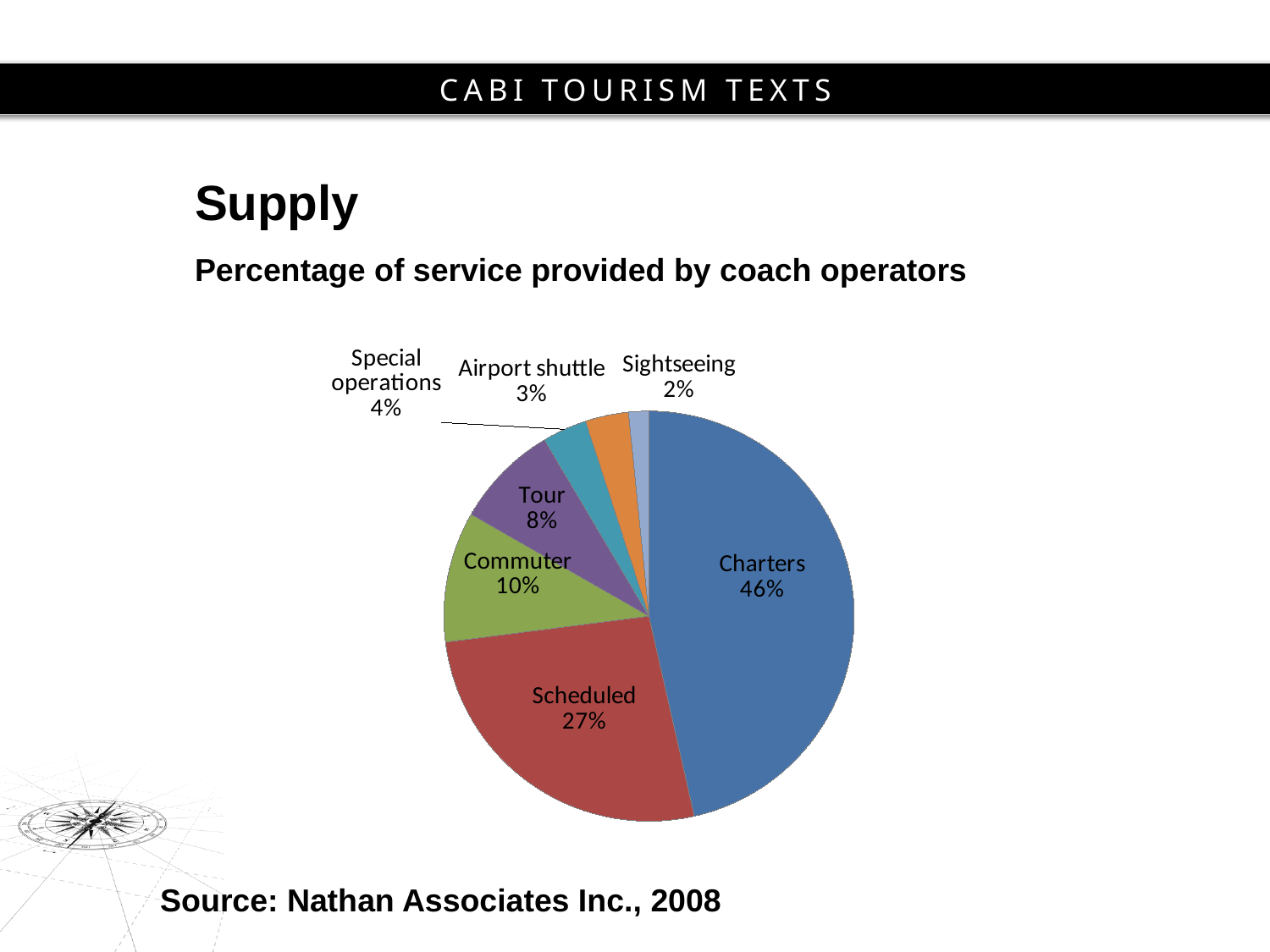
What is the source cited for the chart data? Nathan Associates Inc., 2008 How many service categories are shown in the pie chart? 7 What is the combined share of Special operations and Sightseeing? 6% What percentage of service is Scheduled? 27% Which service category has the smallest share of the pie? Sightseeing What percentage of service is Commuter? 10% What type of chart is shown on the slide? Pie chart What percentage of service is provided by Charters? 46% Which is larger, the share for Tour or the share for Commuter? Commuter What is the difference in percentage points between Charters and Scheduled? 19% Which service category has the largest share of the pie? Charters What percentage of service is Airport shuttle? 3%